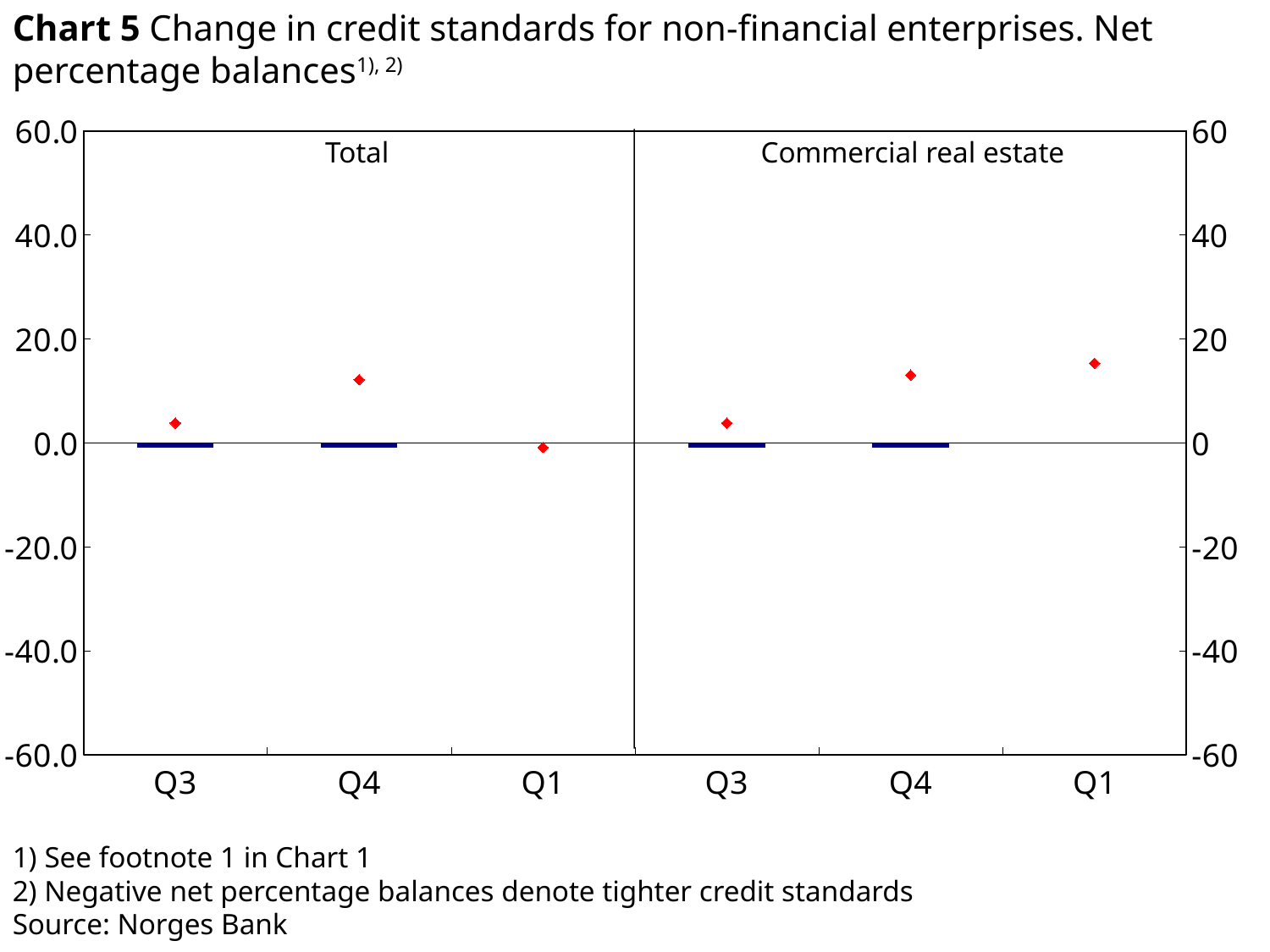
What are the names of the two panels in the chart? Total and Commercial real estate Which is larger: the red marker value for Q3 or for Q4 in the Total panel? Q4 How many quarters are shown in each panel of the chart? 3 Do the red marker values in the Commercial real estate panel rise or fall from Q3 to Q1? rise In the Total panel, which quarter has the lowest red marker value? Q1 In the Total panel, which quarter has the highest red marker value? Q4 Is the red marker value for Q1 in the Commercial real estate panel greater or less than 20? less Is the red marker value for Q3 in the Commercial real estate panel greater or less than 20? less Which is larger: the red marker value for Q1 in the Total panel or Q1 in the Commercial real estate panel? Q1 in the Commercial real estate panel Is the red marker value for Q4 in the Total panel greater or less than 20? less In the Commercial real estate panel, which quarter has the lowest red marker value? Q3